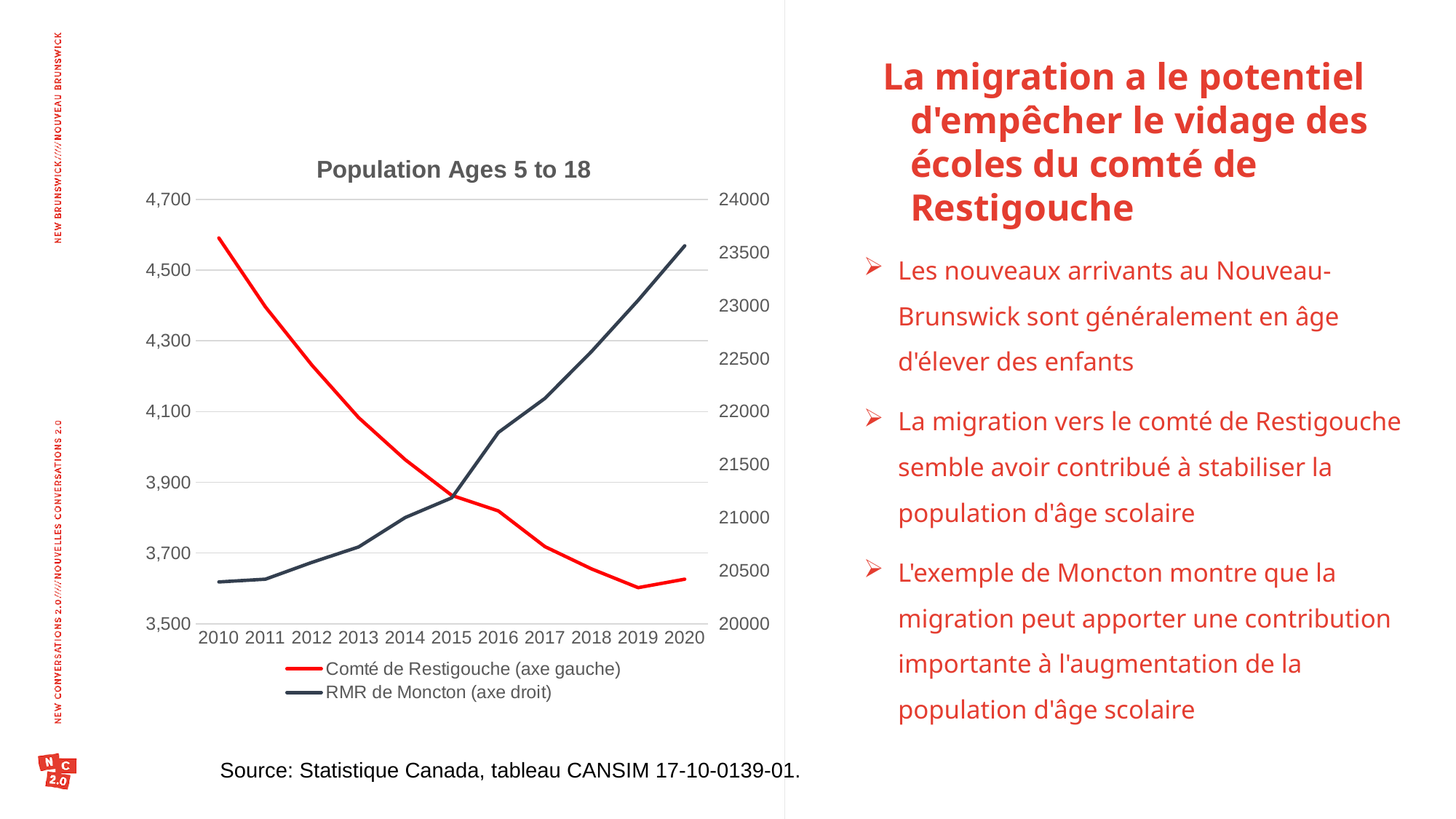
How many series does the chart legend list? 2 Is the Comté de Restigouche value for 2020 greater or less than 3,700? less In which year is the Comté de Restigouche value highest? 2010 Which series is plotted on the right axis according to the legend? RMR de Moncton (axe droit) What kind of chart is shown on the slide? line chart Is the Comté de Restigouche value for 2010 greater or less than 4,500? greater What is the title of the chart? Population Ages 5 to 18 Does the Comté de Restigouche line rise or fall from 2010 to 2020? fall How many years are plotted along the x axis of the chart? 11 Is the RMR de Moncton value for 2010 greater or less than 20500? less Does the RMR de Moncton line rise or fall from 2010 to 2020? rise In which year is the RMR de Moncton value highest? 2020